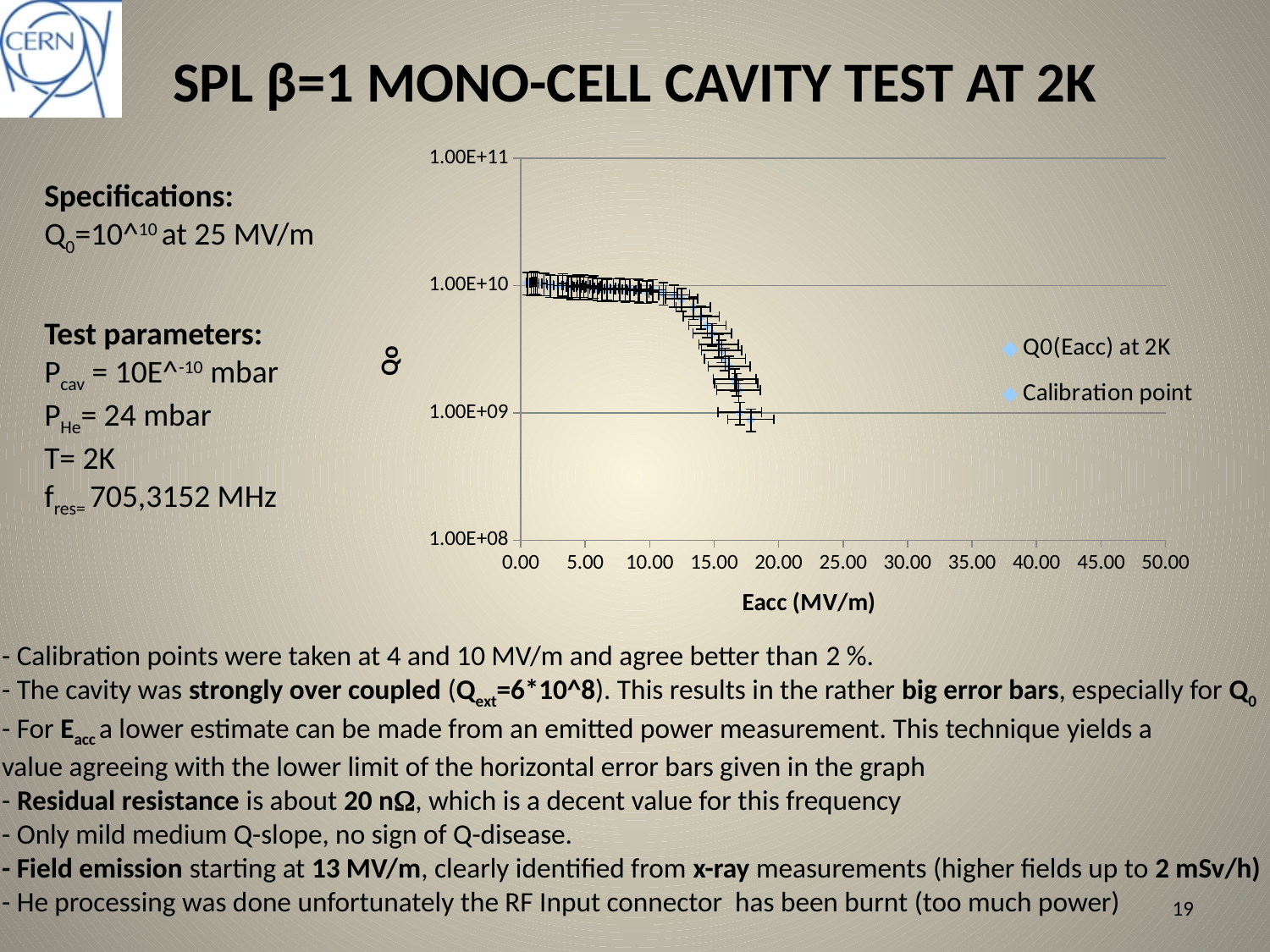
Do any plotted points lie beyond 25.00 MV/m on the x axis? No How many series does the chart legend list? 2 Is the Q0 value at about 5 MV/m greater or less than 1.00E+11? less What are the two series named in the chart legend? Q0(Eacc) at 2K and Calibration point Is the Q0 value at about 5 MV/m greater or less than 1.00E+09? greater What is the label of the x axis of the chart? Eacc (MV/m) What kind of chart is shown on the slide? Scatter chart (with error bars) What is the highest tick value shown on the x axis of the chart? 50.00 Does Q0 rise or fall as Eacc increases along the x axis? Fall